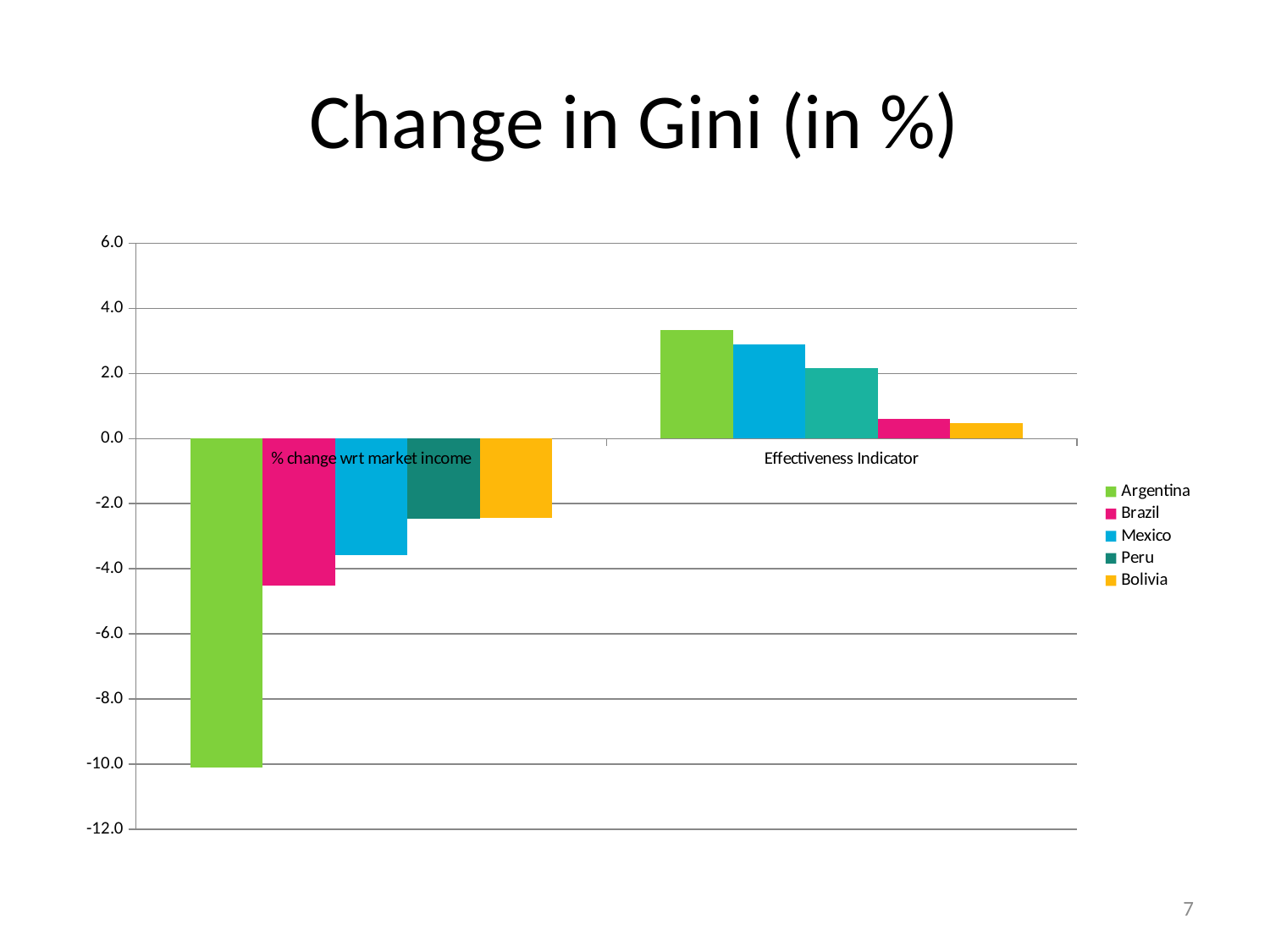
Which country has the lowest value for % change wrt market income? Argentina Under Effectiveness Indicator, which is larger, the value for Mexico or the value for Peru? Mexico What is the title of the chart? Change in Gini (in %) Is the value for Argentina under % change wrt market income greater or less than -8.0? less Is the value for Brazil under % change wrt market income greater or less than -4.0? less Which country has the highest value for Effectiveness Indicator? Argentina What kind of chart is shown on the slide? bar chart How many categories are shown on the x axis? 2 Under % change wrt market income, which is larger, the value for Mexico or the value for Brazil? Mexico How many series does the legend list? 5 Which colour represents Bolivia in the legend? yellow Is the value for Mexico under Effectiveness Indicator greater or less than 2.0? greater